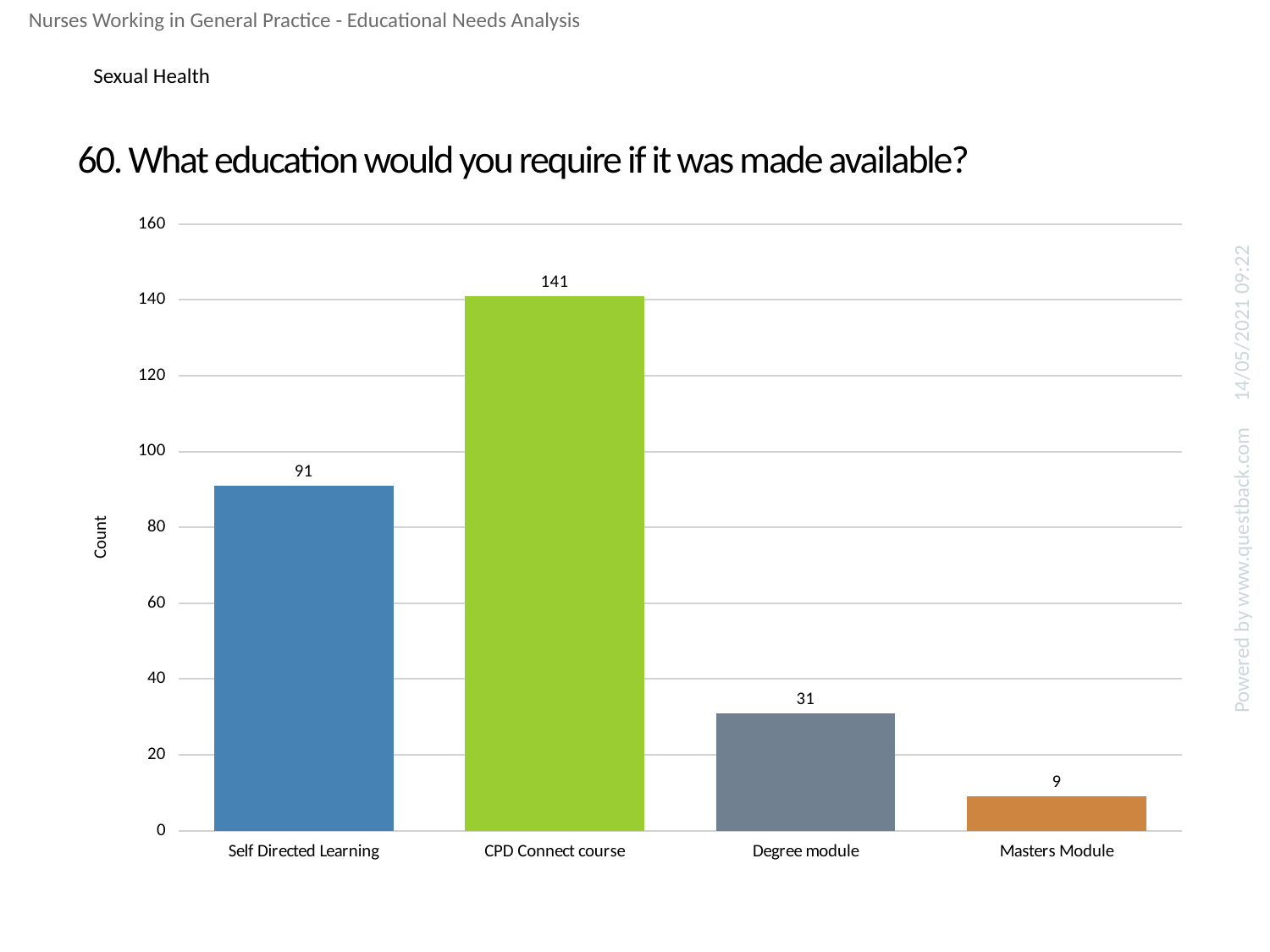
What is the count for CPD Connect course? 141 Which has a larger count, Self Directed Learning or Degree module? Self Directed Learning What is the difference between the counts for CPD Connect course and Self Directed Learning? 50 What is the count for Masters Module? 9 Which category has the lowest count? Masters Module What is the difference between the counts for Degree module and Masters Module? 22 How many categories are shown on the chart? 4 Which category has the highest count? CPD Connect course What is the count for Degree module? 31 What is the count for Self Directed Learning? 91 What is the label of the vertical axis? Count What kind of chart is shown on the slide? Bar chart